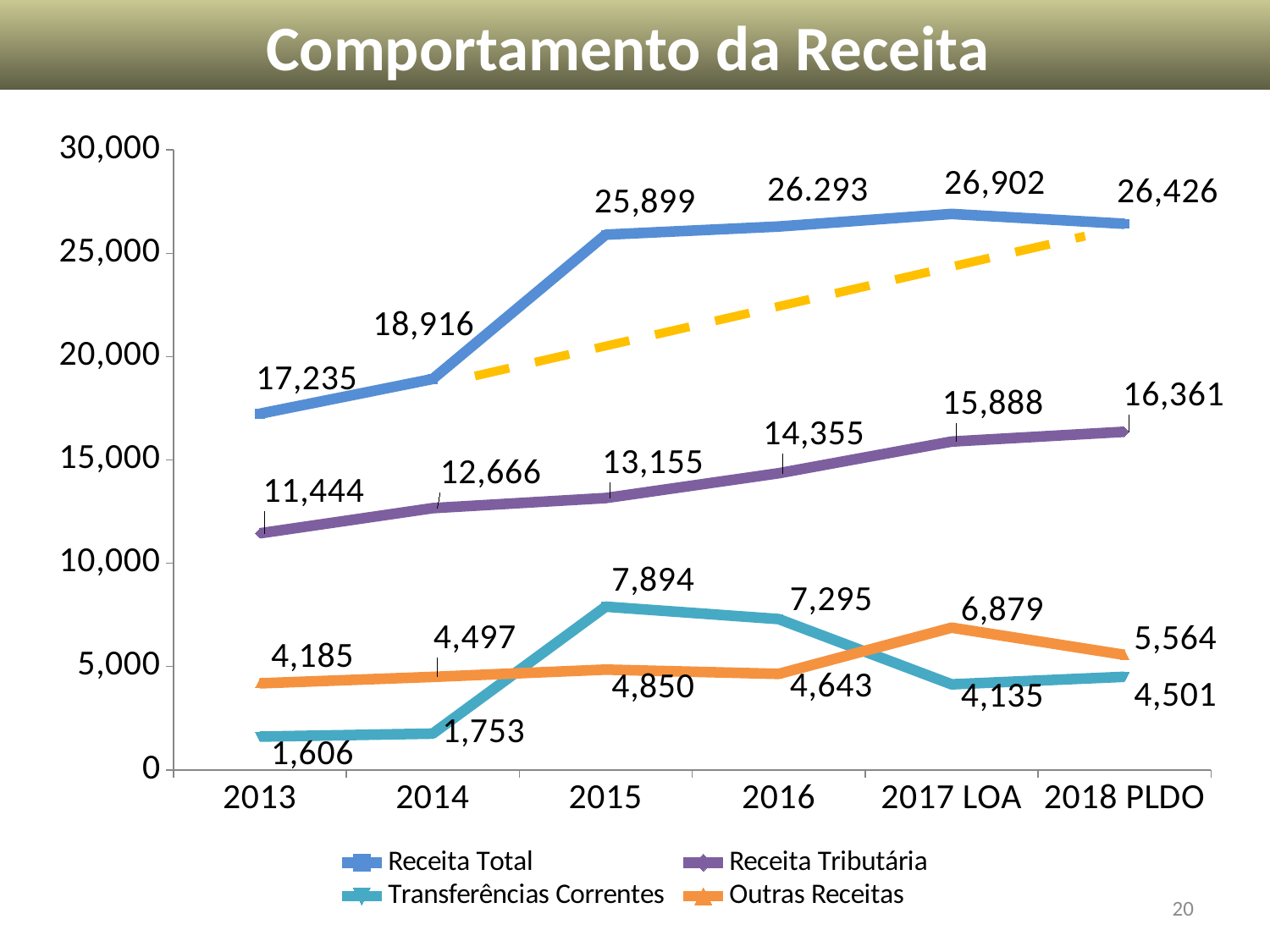
What is the value of Receita Total in 2015? 25,899 In which year is Transferências Correntes lowest? 2013 What is the value of Outras Receitas in 2017 LOA? 6,879 In which year does Receita Total reach its highest value? 2017 LOA What is the difference between Receita Total in 2014 and in 2013? 1,681 Does Receita Tributária rise or fall from 2013 to 2018 PLDO? Rise What is the value of Receita Tributária in 2018 PLDO? 16,361 Which is larger in 2016: Transferências Correntes or Outras Receitas? Transferências Correntes How many series does the legend list? 4 What kind of chart is shown on the slide? Line chart What is the value of Transferências Correntes in 2013? 1,606 How many years are shown on the x axis? 6